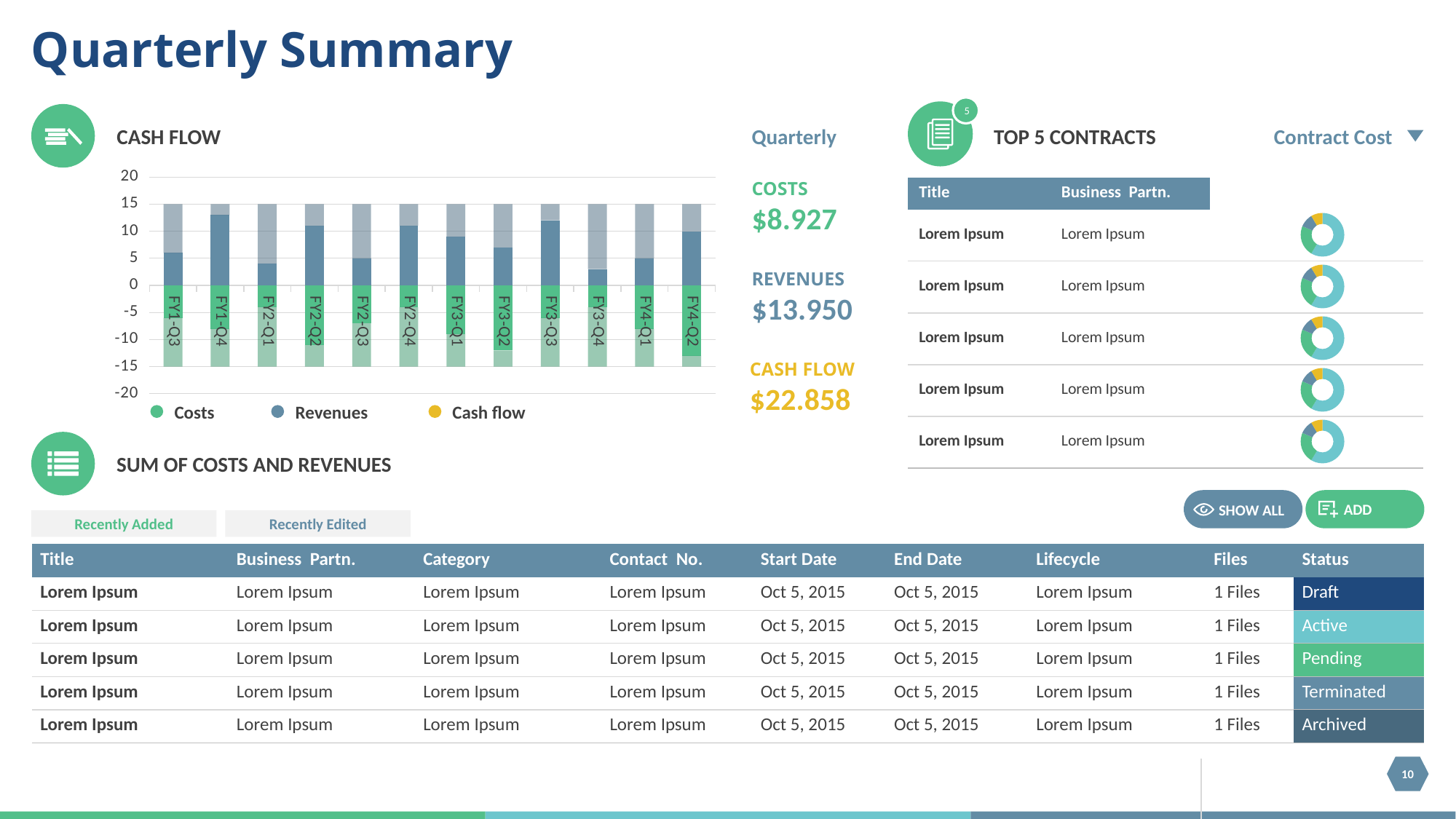
What is the highest value shown on the y axis of the CASH FLOW chart? 20 What kind of chart is the CASH FLOW chart? bar chart In the CASH FLOW chart, is the Revenues value for FY3-Q4 greater or less than 5? less How many quarters are shown on the x axis of the CASH FLOW chart? 12 In the CASH FLOW chart, is the Revenues value for FY2-Q1 greater or less than 5? less In the CASH FLOW chart, is the Revenues value for FY2-Q3 greater or less than 10? less In the CASH FLOW chart, which is larger, the Revenues value for FY2-Q2 or for FY2-Q1? FY2-Q2 In the CASH FLOW chart, which is larger, the Revenues value for FY1-Q4 or for FY3-Q4? FY1-Q4 What is the first quarter shown on the x axis of the CASH FLOW chart? FY1-Q3 How many series does the legend of the CASH FLOW chart list? 3